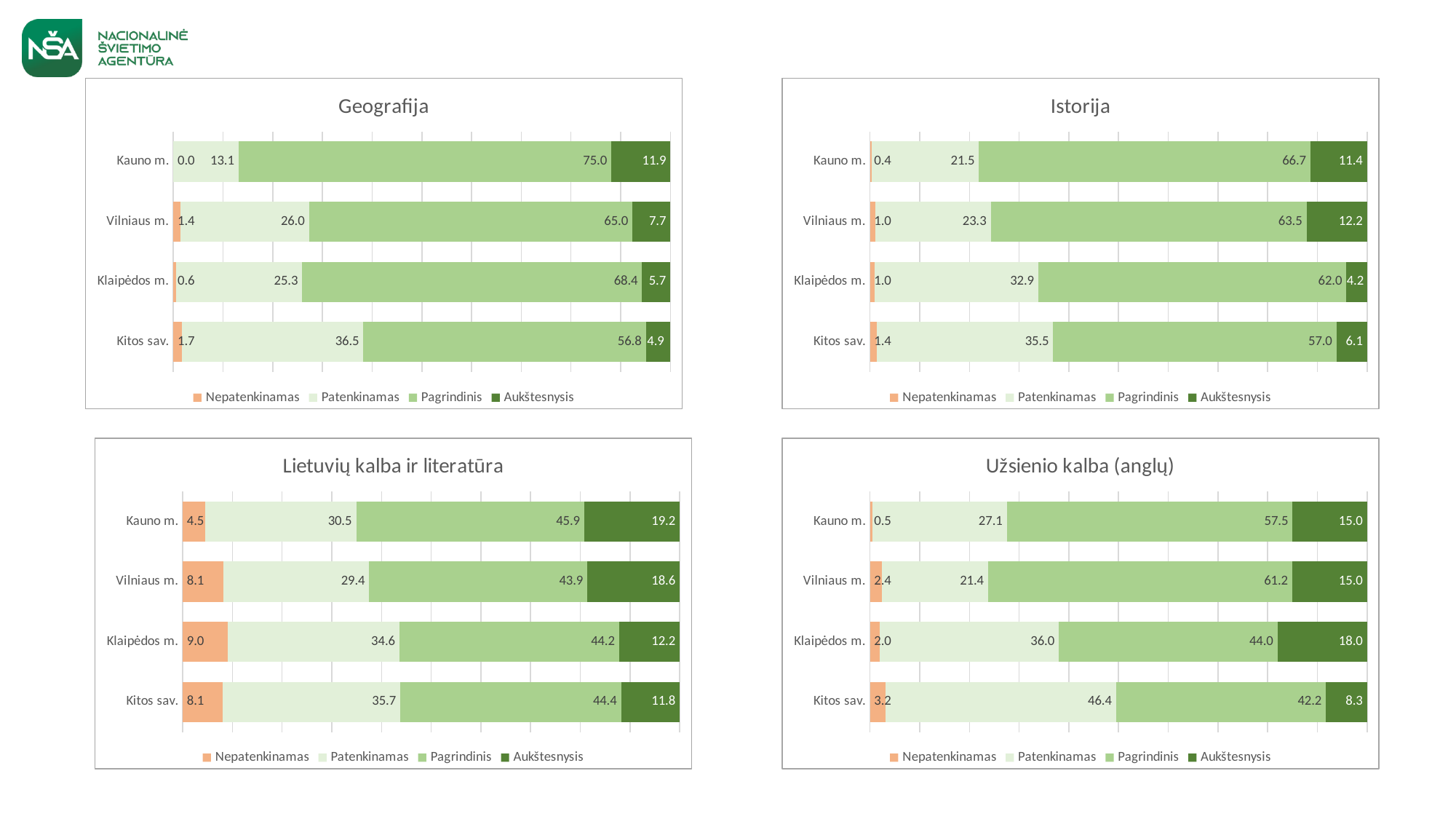
In the Užsienio kalba (anglų) chart, is the Pagrindinis value larger for Vilniaus m. or Klaipėdos m.? Vilniaus m. In the Užsienio kalba (anglų) chart, what is the Aukštesnysis value for Kitos sav.? 8.3 In the Istorija chart, what is the Patenkinamas value for Klaipėdos m.? 32.9 In the Užsienio kalba (anglų) chart, what is the total of the stacked bar for Klaipėdos m.? 100.0 In the Geografija chart, which category has the highest Aukštesnysis value? Kauno m. In the Istorija chart, which category has the lowest Aukštesnysis value? Klaipėdos m. In the Geografija chart, what is the Pagrindinis value for Kauno m.? 75.0 How many categories are shown in the Geografija chart? 4 In the Lietuvių kalba ir literatūra chart, what is the difference between the Aukštesnysis values for Kauno m. and Kitos sav.? 7.4 What kind of chart is the Lietuvių kalba ir literatūra chart? Stacked bar chart How many series does the legend of the Istorija chart list? 4 In the Lietuvių kalba ir literatūra chart, what is the Nepatenkinamas value for Klaipėdos m.? 9.0